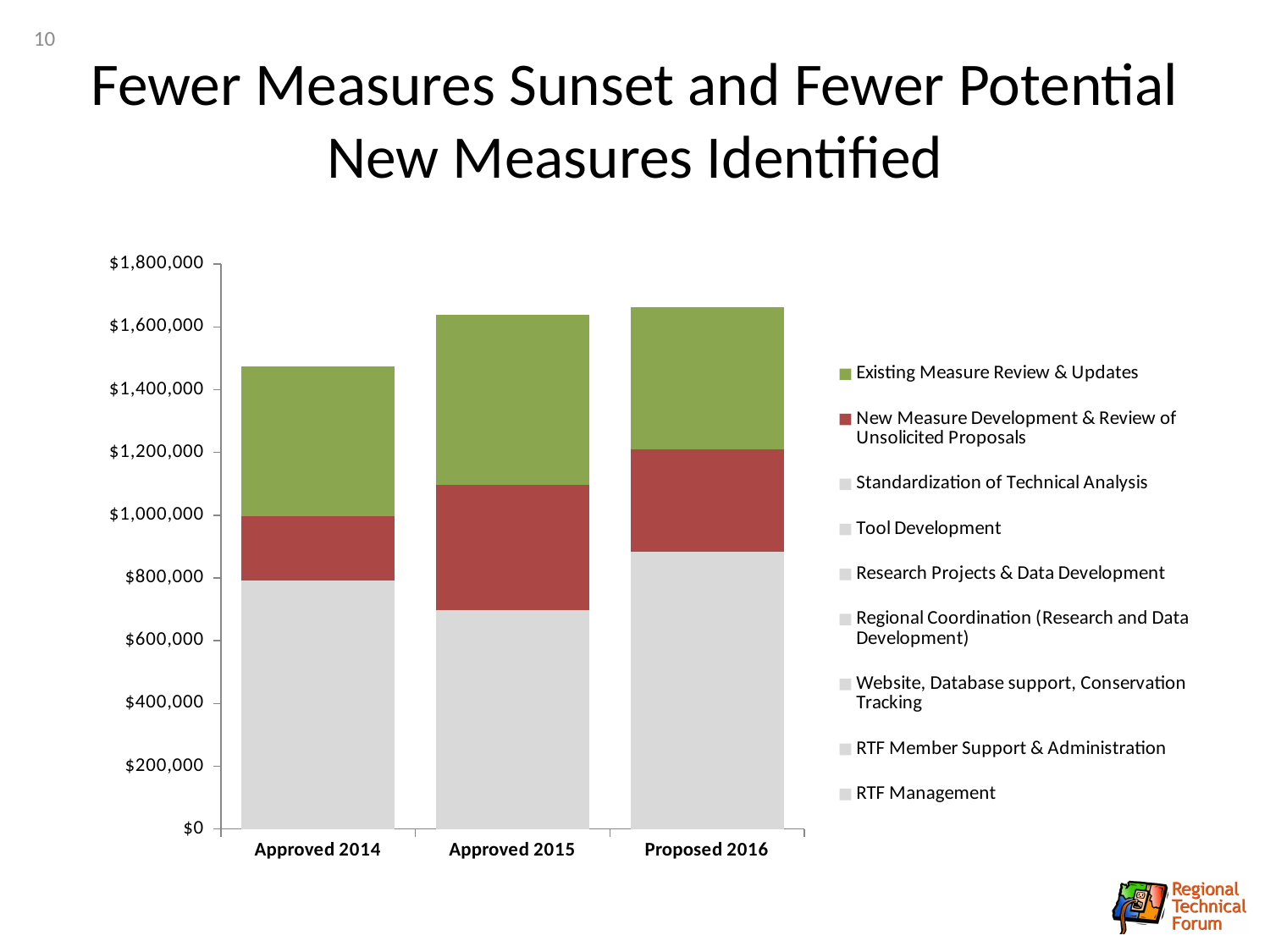
Which legend entry is shown in green? Existing Measure Review & Updates What is the title of the slide containing the chart? Fewer Measures Sunset and Fewer Potential New Measures Identified Is the total for Approved 2015 greater or less than $1,600,000? greater Is the total for Proposed 2016 greater or less than $1,600,000? greater Which budget year has the lowest total bar? Approved 2014 Do the total bar heights rise or fall from Approved 2014 to Proposed 2016? rise Is the total for Approved 2014 greater or less than $1,600,000? less Which total is larger, Approved 2014 or Approved 2015? Approved 2015 How many budget years (categories) are shown on the x axis? 3 How many series does the legend list? 9 What kind of chart is shown on the slide? Stacked bar chart